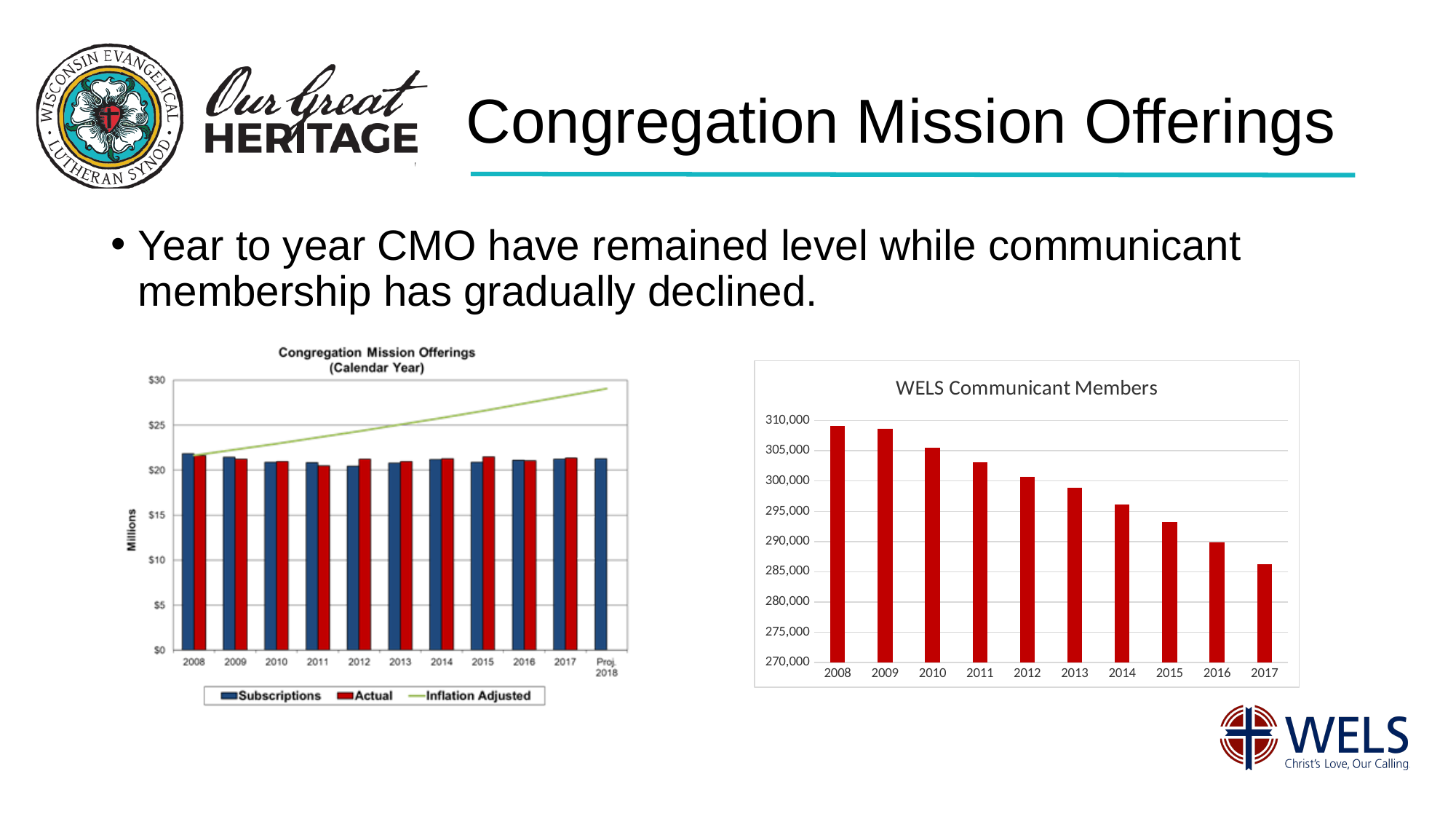
In the WELS Communicant Members chart, is the value for 2010 greater or less than 305,000? greater In the WELS Communicant Members chart, which year has the highest value? 2008 In the Congregation Mission Offerings (Calendar Year) chart, how many series does the legend list? 3 In the Congregation Mission Offerings (Calendar Year) chart, what are the three legend entries? Subscriptions, Actual, Inflation Adjusted In the WELS Communicant Members chart, is the value for 2017 greater or less than 290,000? less In the WELS Communicant Members chart, how many years are shown on the x axis? 10 In the Congregation Mission Offerings (Calendar Year) chart, is the Actual value for 2008 greater or less than $20 million? greater In the Congregation Mission Offerings (Calendar Year) chart, does the Inflation Adjusted line rise or fall from 2008 to Proj. 2018? rise In the WELS Communicant Members chart, what kind of chart is used? bar chart In the WELS Communicant Members chart, which is larger, the value for 2012 or the value for 2015? 2012 In the WELS Communicant Members chart, which year has the lowest value? 2017 In the WELS Communicant Members chart, do the values rise or fall from 2008 to 2017? fall